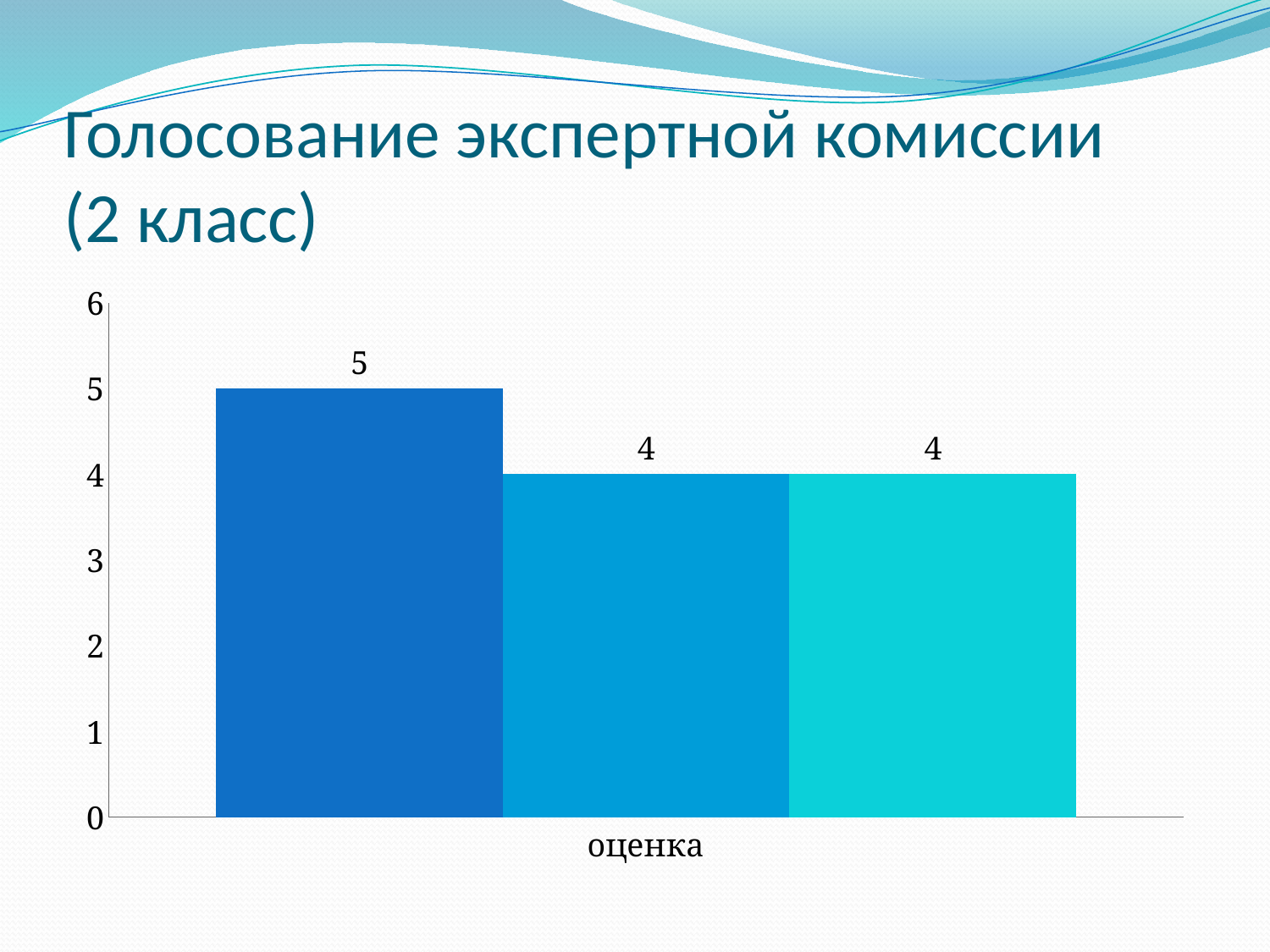
Which is larger, the leftmost bar or the rightmost bar? the leftmost bar Is the value of the leftmost bar greater or less than 3? greater What is the value of the rightmost (light cyan) bar? 4 What kind of chart is shown on the slide? bar chart What is the difference between the leftmost bar and the middle bar? 1 What is the title of the slide containing the chart? Голосование экспертной комиссии (2 класс) What is the category label shown on the x axis? оценка Which bar has the highest value? the leftmost (dark blue) bar What is the value of the middle bar? 4 What is the value of the leftmost (dark blue) bar? 5 How many bars are plotted in the chart? 3 What is the highest tick value shown on the y axis? 6